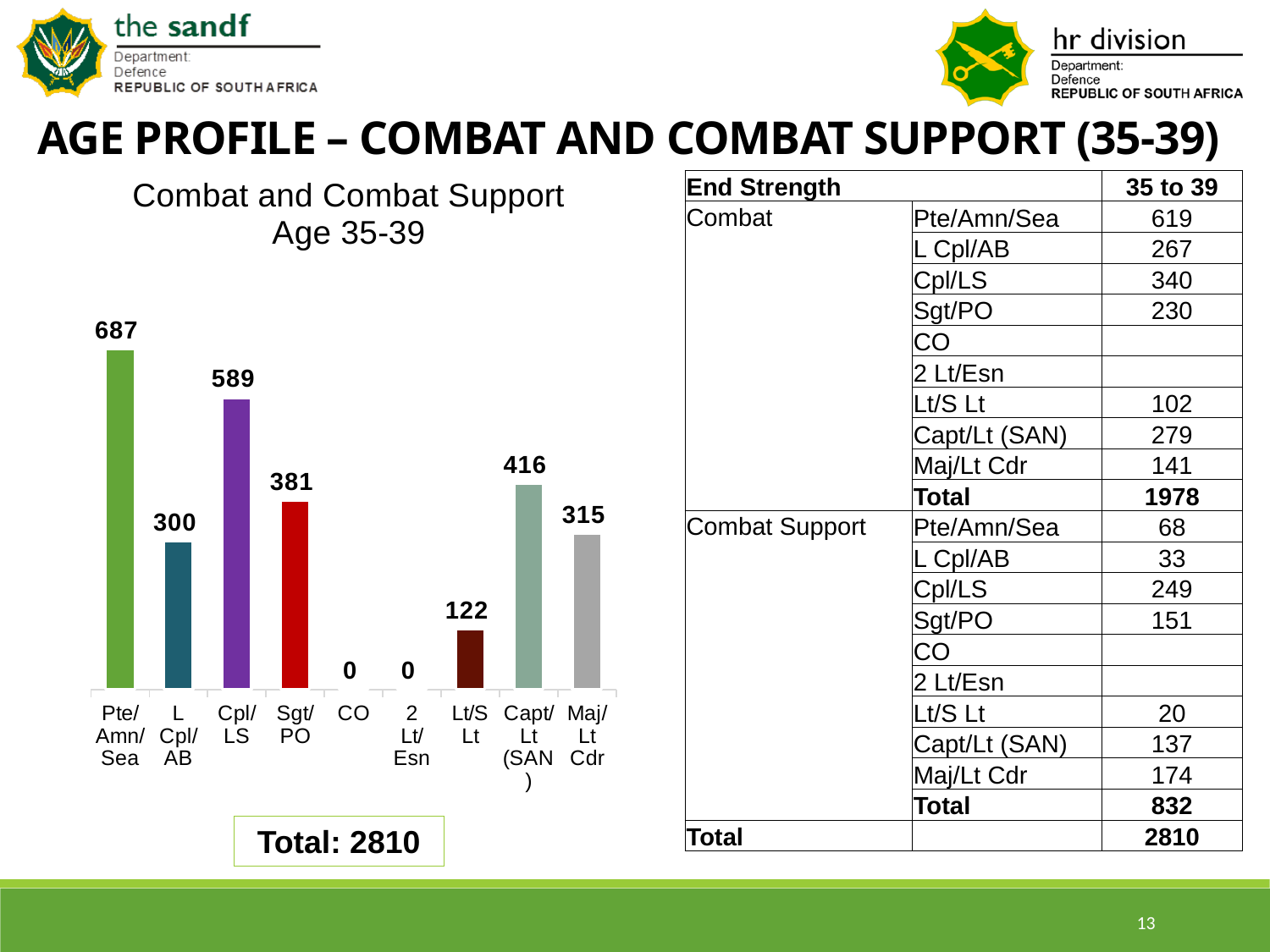
What is the value for Capt/Lt (SAN) in the chart? 416 What is the title of the chart? Combat and Combat Support Age 35-39 Which categories have a value of 0 in the chart? CO and 2 Lt/Esn What kind of chart is shown on the slide? Bar chart What is the value for Lt/S Lt in the chart? 122 Which category has the highest value in the chart? Pte/Amn/Sea Which is larger, the value for Capt/Lt (SAN) or the value for Maj/Lt Cdr? Capt/Lt (SAN) What is the difference between the values for Pte/Amn/Sea and Cpl/LS? 98 What total is shown in the box below the chart? Total: 2810 What is the difference between the values for Sgt/PO and L Cpl/AB? 81 How many categories are shown on the x axis of the chart? 9 What is the value for Pte/Amn/Sea in the chart? 687